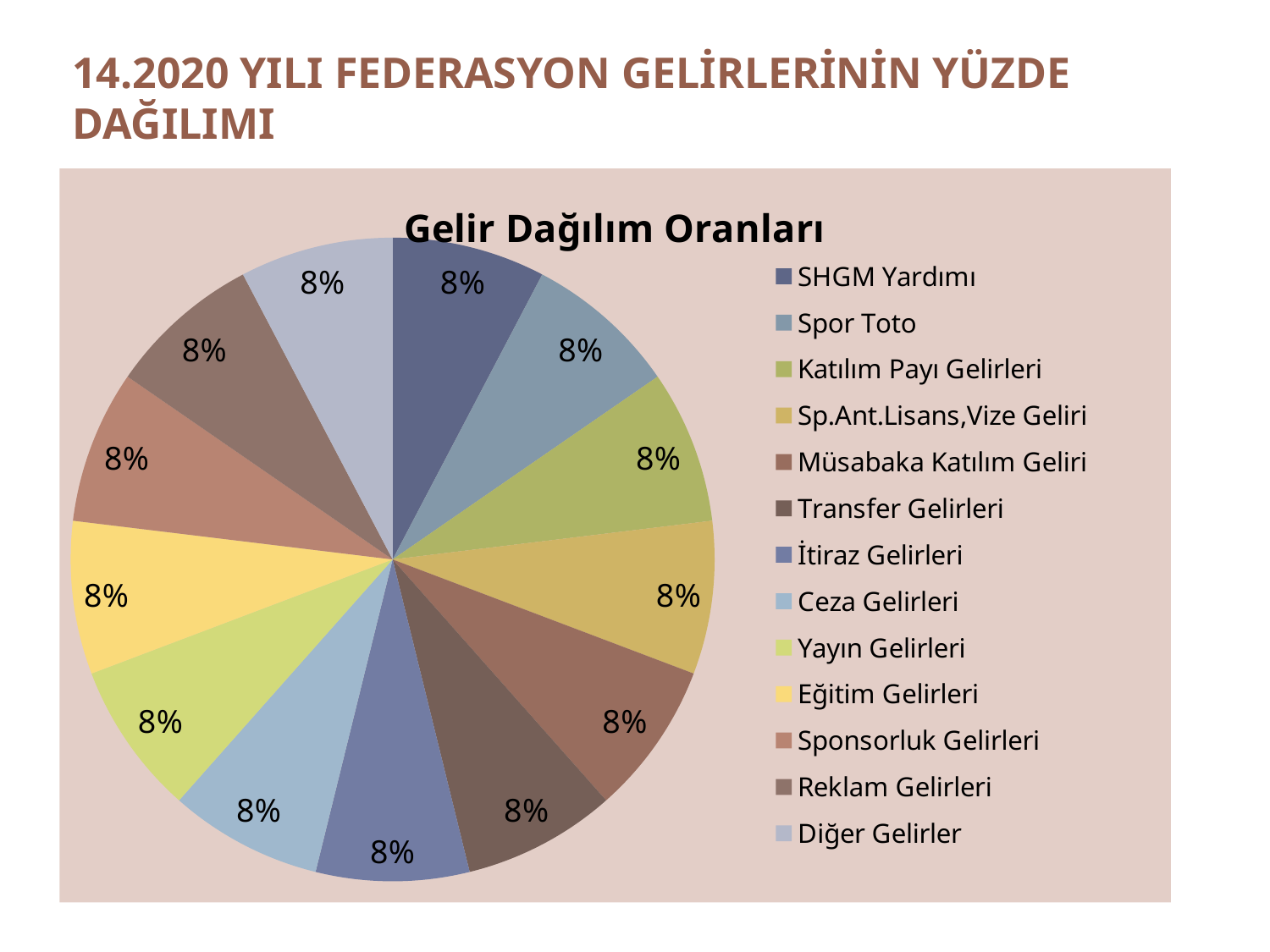
What kind of chart is shown on the slide? pie chart How many slices does the pie chart have? 13 What percentage is shown for Transfer Gelirleri? 8% What percentage is shown for Ceza Gelirleri? 8% What is the difference between the percentages shown for Reklam Gelirleri and Yayın Gelirleri? 0% What share of the pie is labelled for SHGM Yardımı? 8% What percentage is shown for Diğer Gelirler? 8% What percentage is shown for Sponsorluk Gelirleri? 8% What percentage is shown for Eğitim Gelirleri? 8% Which legend entry is listed last in the chart's legend? Diğer Gelirler What is the title of the chart? Gelir Dağılım Oranları What share of the pie is labelled for Spor Toto? 8%